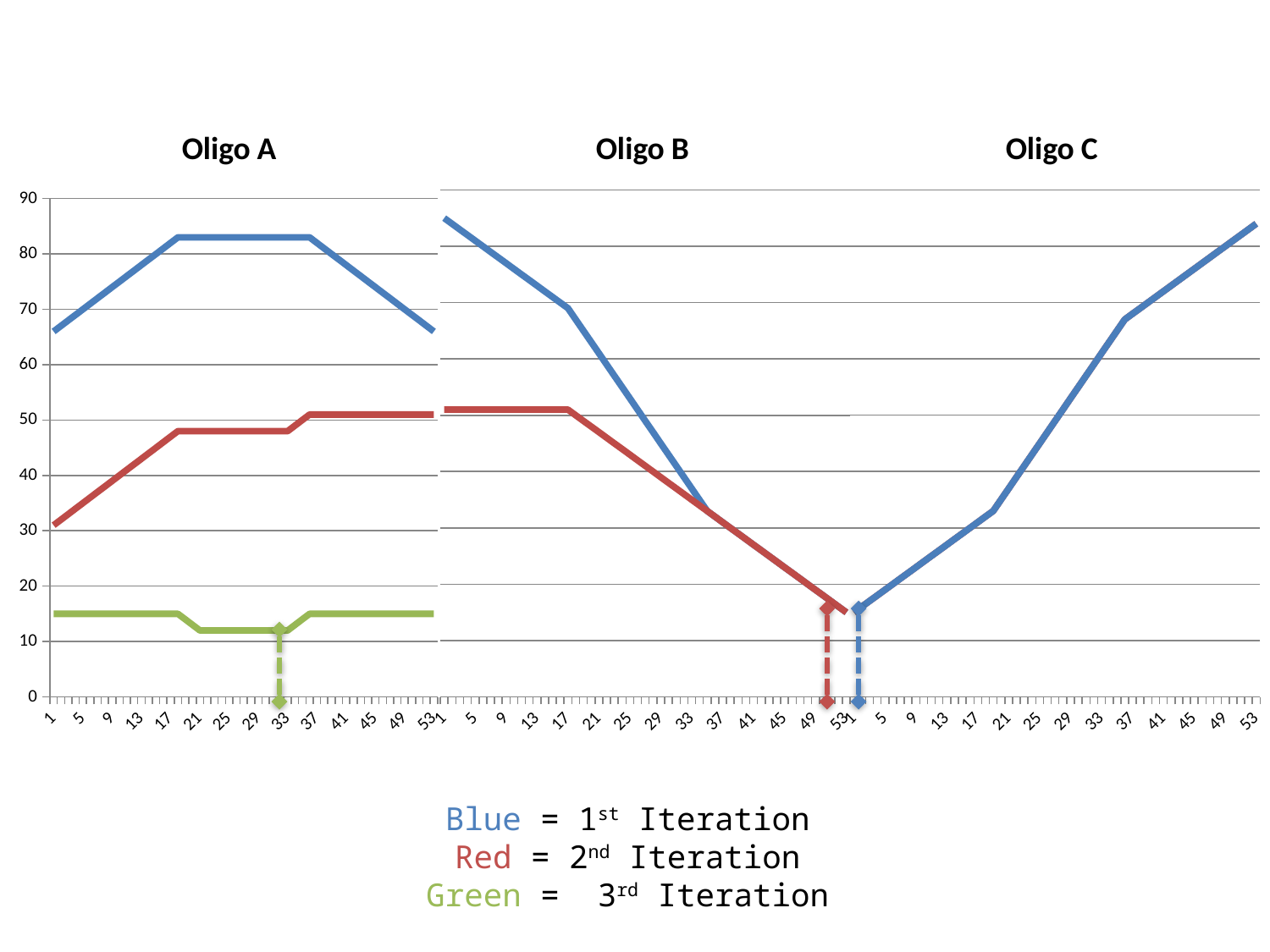
In the Oligo A section, is the blue line's value at x = 1 greater or less than 60? greater What are the titles of the three chart sections? Oligo A, Oligo B, Oligo C Which colour represents the 2nd iteration according to the legend? Red In the Oligo C section, does the blue line rise or fall along the x axis? rise In the Oligo A section, which line is the highest overall: blue, red or green? blue In the Oligo A section, is the green line's value at x = 1 greater or less than 20? less In the Oligo C section, is the blue line's value at x = 53 greater or less than 80? greater How many iterations does the legend below the chart list? 3 What kind of chart is shown on the slide? line chart In the Oligo B section, does the blue line rise or fall along the x axis? fall